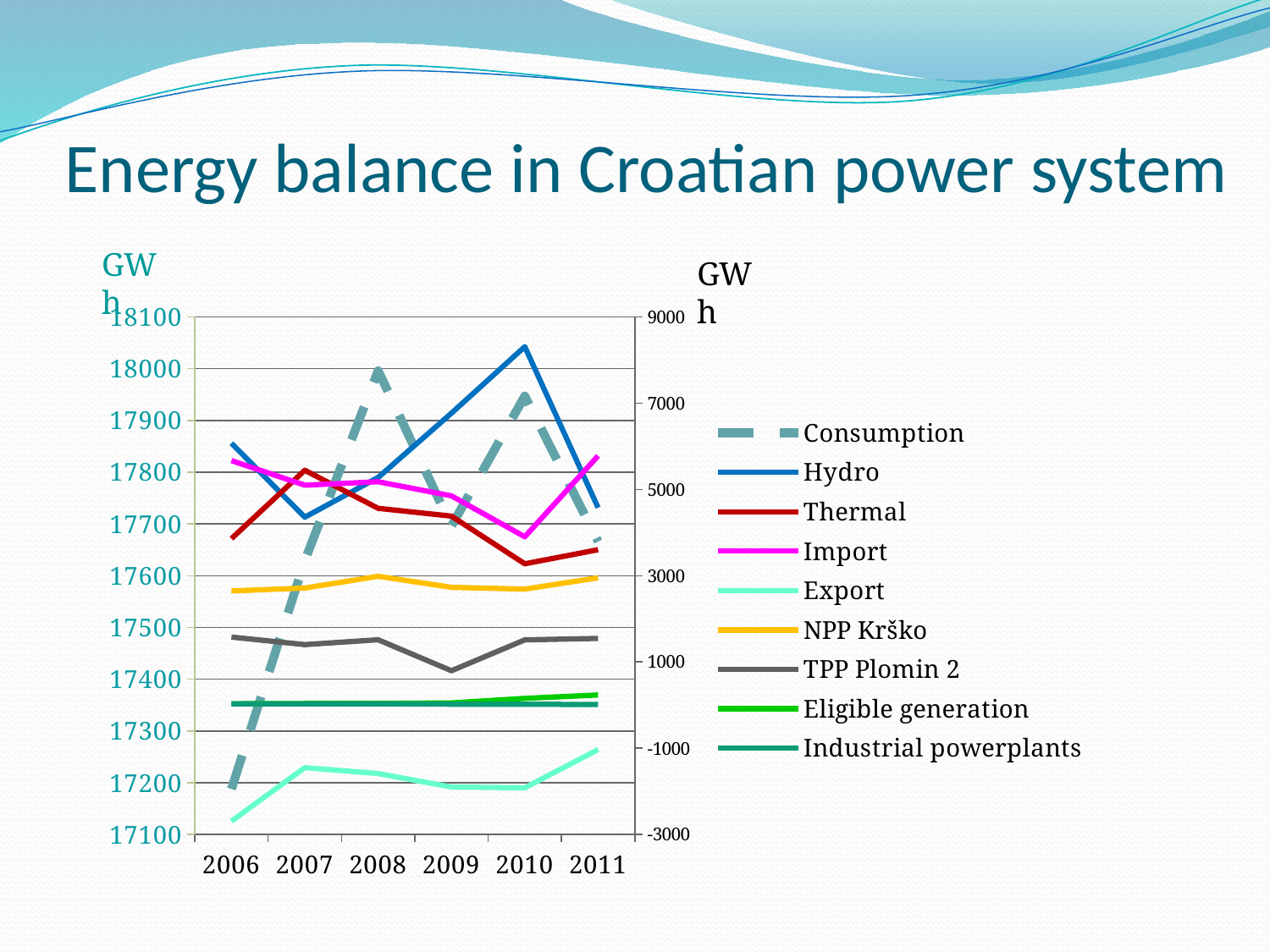
Is the value for Hydro in 2010 greater or less than 7000? greater What kind of chart is shown on the slide? line chart Which is larger in 2010, Hydro or Thermal? Hydro In which year is Consumption at its lowest? 2006 In which year is TPP Plomin 2 at its lowest? 2009 In which year does Consumption reach its highest value? 2008 Which series is drawn with a dashed line? Consumption How many years are shown on the x axis? 6 In which year is Export at its lowest? 2006 Is the value for Consumption in 2006 greater or less than 17300? less In which year does Hydro reach its highest value? 2010 How many series does the legend list? 9